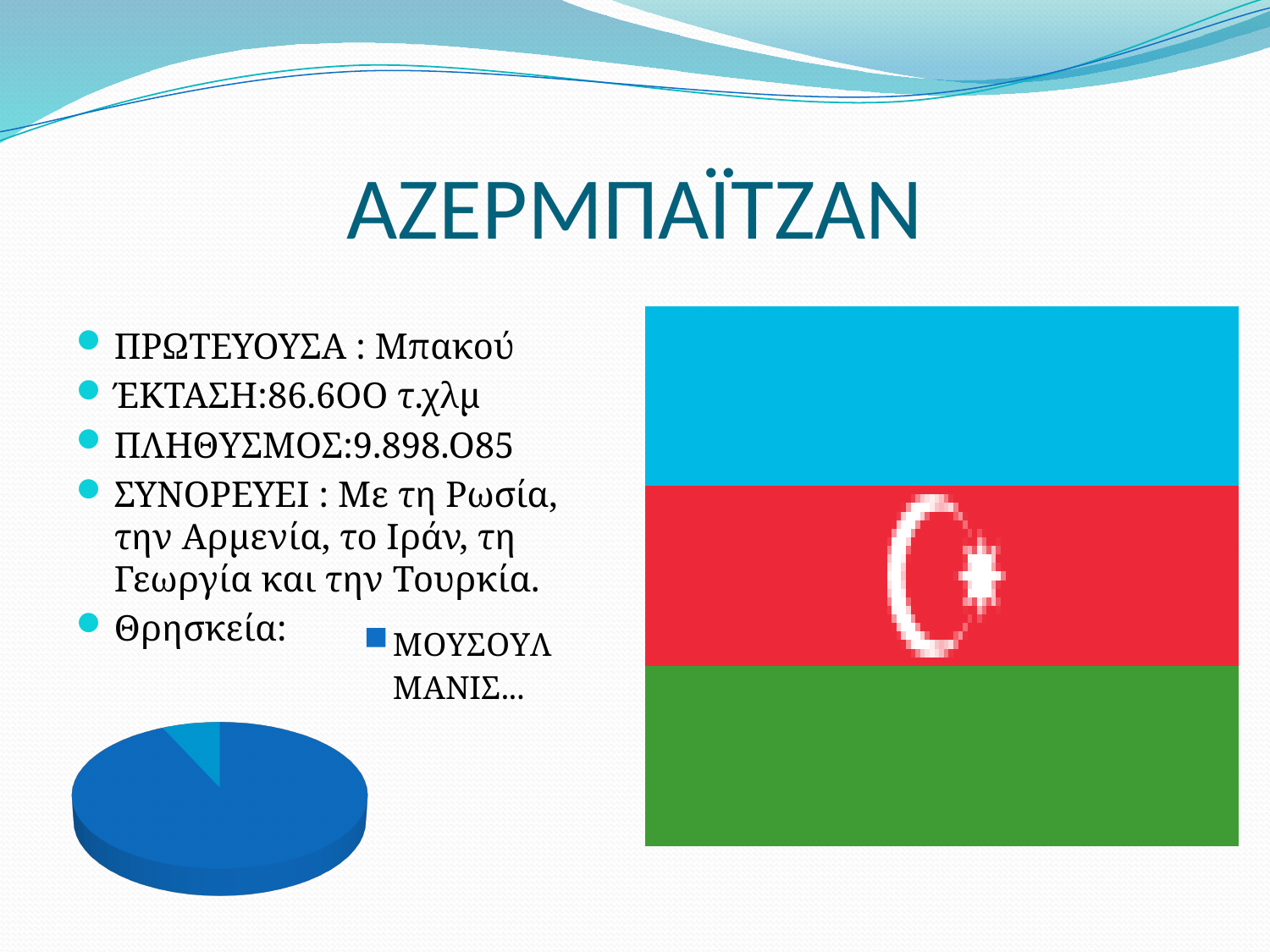
What kind of chart is shown at the bottom left of the slide? pie chart How many slices does the pie chart have? 2 How many entries does the legend of the pie chart list? 1 Is the pie chart drawn in 3D or flat? 3D Is the dark blue slice of the pie chart larger or smaller than the light blue slice? larger Which slice of the pie chart is the largest, the dark blue one or the light blue one? the dark blue one Which slice of the pie chart is the smallest, the dark blue one or the light blue one? the light blue one What does the legend entry next to the pie chart read? ΜΟΥΣΟΥΛΜΑΝΙΣ…